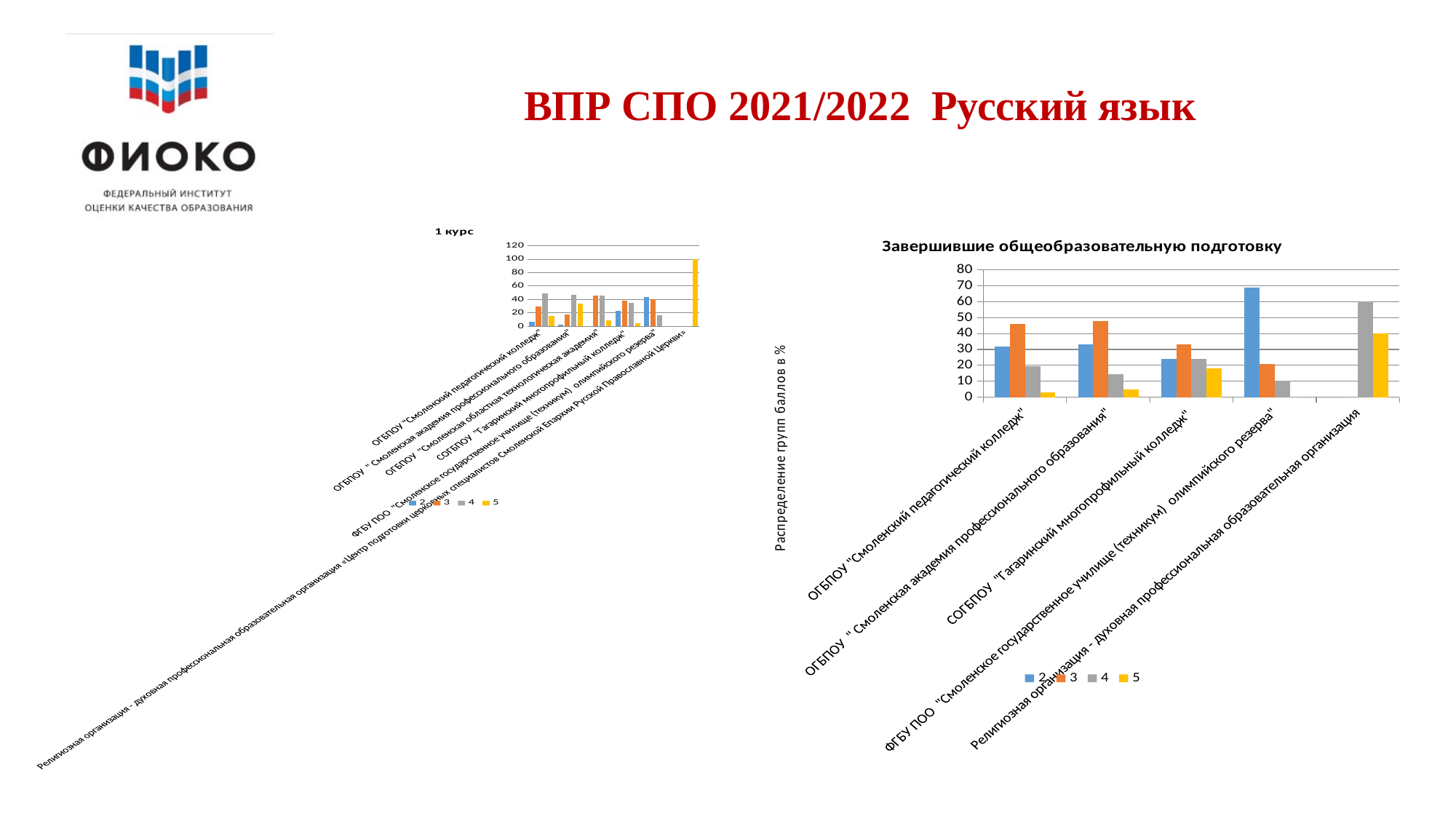
In the chart "Завершившие общеобразовательную подготовку", which organisation has the highest value for series 5? Религиозная организация - духовная профессиональная образовательная организация How many series does the legend of the chart titled "1 курс" list? 4 What kind of chart is the chart titled "Завершившие общеобразовательную подготовку"? bar chart How many categories (organisations) are shown on the x axis of the chart "Завершившие общеобразовательную подготовку"? 5 In the chart "Завершившие общеобразовательную подготовку", is the value of series 5 for Религиозная организация - духовная профессиональная образовательная организация greater or less than 30? greater In the chart "Завершившие общеобразовательную подготовку", is the value of series 2 for ФГБУ ПОО "Смоленское государственное училище (техникум) олимпийского резерва" greater or less than 60? greater How many categories are shown on the x axis of the chart titled "1 курс"? 6 In the chart "Завершившие общеобразовательную подготовку", which organisation has the highest value for series 2? ФГБУ ПОО "Смоленское государственное училище (техникум) олимпийского резерва" In the chart titled "1 курс", is the value of series 5 for the last category (Религиозная организация) greater or less than 80? greater What is the label of the vertical axis of the chart "Завершившие общеобразовательную подготовку"? Распределение групп баллов в % How many series does the legend of the chart "Завершившие общеобразовательную подготовку" list? 4 In the chart "Завершившие общеобразовательную подготовку", for ОГБПОУ "Смоленский педагогический колледж", which is larger: series 2 or series 3? series 3